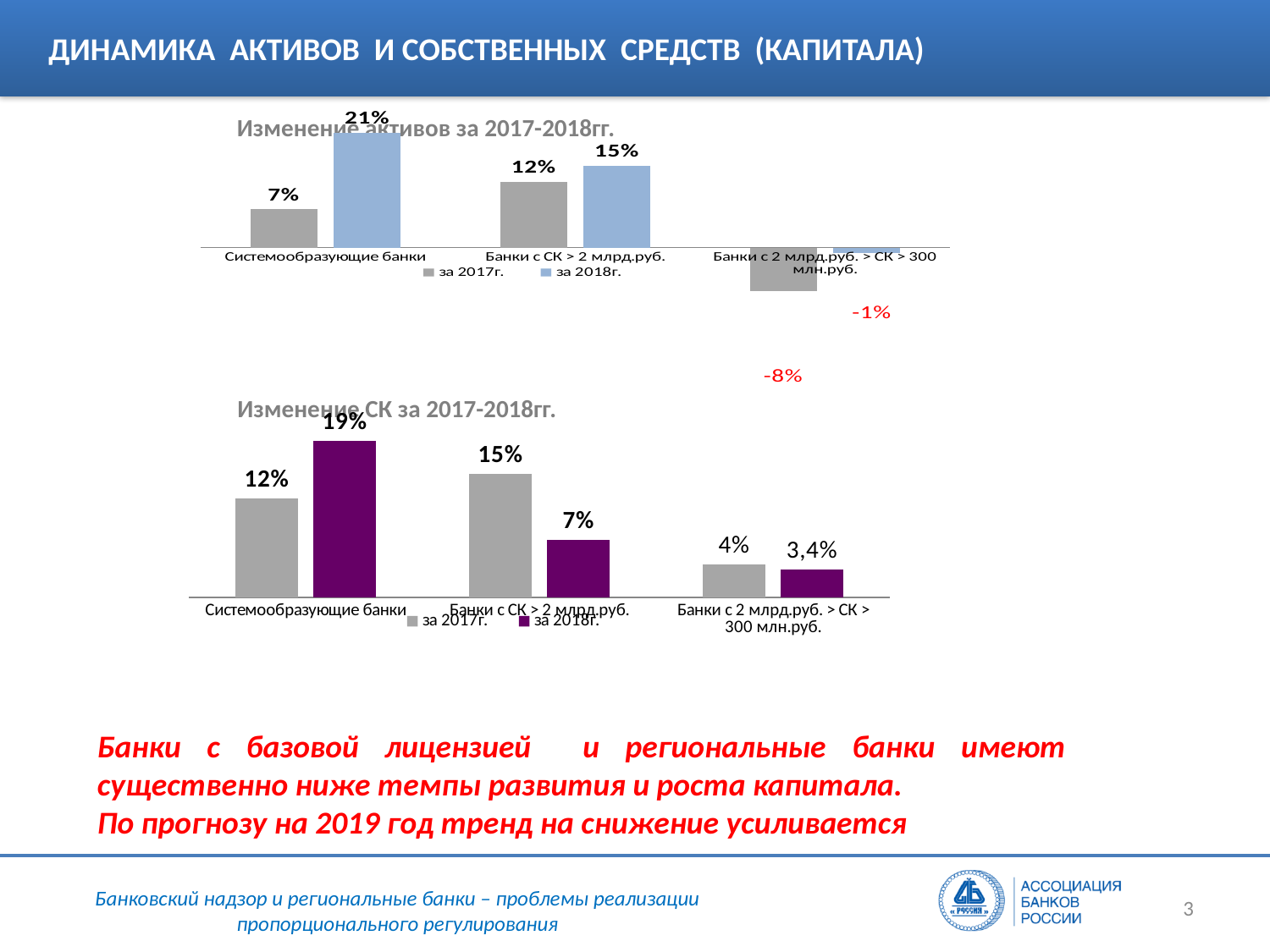
On the chart 'Изменение активов за 2017-2018гг.', what is the difference between the за 2018г. and за 2017г. values for Системообразующие банки? 14% On the chart 'Изменение СК за 2017-2018гг.', what is the difference between the за 2017г. and за 2018г. values for Системообразующие банки? 7% On the chart 'Изменение активов за 2017-2018гг.', what is the value for Системообразующие банки for за 2018г.? 21% On the chart 'Изменение активов за 2017-2018гг.', how many series does the legend list? 2 What type of chart is 'Изменение СК за 2017-2018гг.'? Bar chart On the chart 'Изменение активов за 2017-2018гг.', which category has the highest за 2018г. value? Системообразующие банки On the chart 'Изменение СК за 2017-2018гг.', what is the value for Банки с СК > 2 млрд.руб. for за 2018г.? 7% On the chart 'Изменение СК за 2017-2018гг.', what is the value for Банки с 2 млрд.руб. > СК > 300 млн.руб. for за 2018г.? 3,4% On the chart 'Изменение СК за 2017-2018гг.', which category has the lowest за 2017г. value? Банки с 2 млрд.руб. > СК > 300 млн.руб. On the chart 'Изменение СК за 2017-2018гг.', how many categories are shown on the x axis? 3 On the chart 'Изменение СК за 2017-2018гг.', which is larger for Банки с СК > 2 млрд.руб.: the за 2017г. value or the за 2018г. value? за 2017г. On the chart 'Изменение активов за 2017-2018гг.', what is the value for Банки с СК > 2 млрд.руб. for за 2017г.? 12%